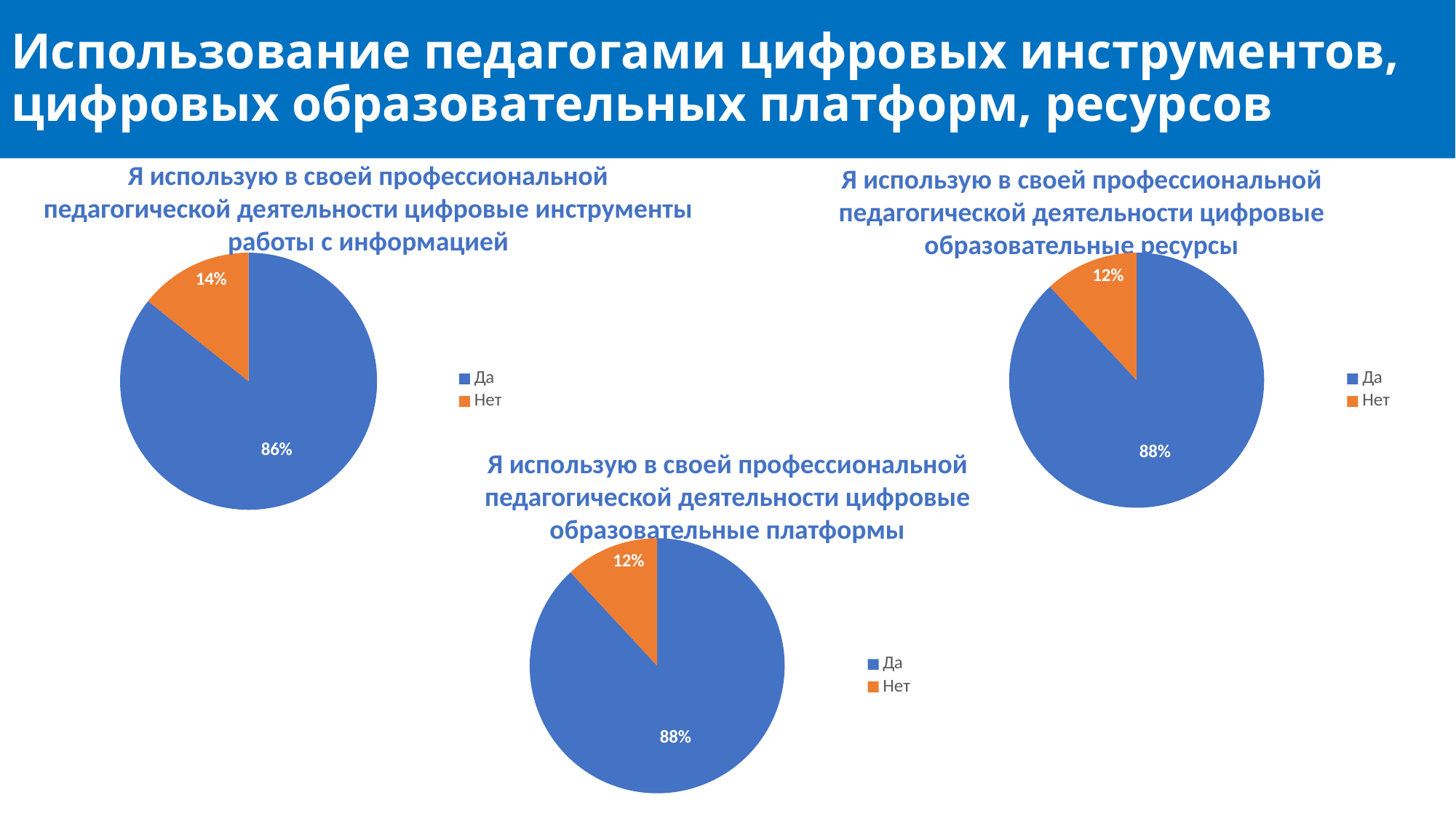
In the top-left pie chart (цифровые инструменты работы с информацией), what is the difference between the "Да" and "Нет" shares? 72% In the top-left pie chart (цифровые инструменты работы с информацией), what percentage answered "Да"? 86% In the top-right pie chart (цифровые образовательные ресурсы), what percentage answered "Нет"? 12% In the bottom pie chart (цифровые образовательные платформы), what percentage answered "Да"? 88% How many entries does the legend of the top-right pie chart (цифровые образовательные ресурсы) list? 2 In the bottom pie chart (цифровые образовательные платформы), what percentage answered "Нет"? 12% How many pie charts are shown on the slide? 3 What type of chart is used for the bottom chart (цифровые образовательные платформы)? Pie chart In the top-left pie chart (цифровые инструменты работы с информацией), what percentage answered "Нет"? 14% In the top-right pie chart (цифровые образовательные ресурсы), which answer has the smallest share? Нет In the top-left pie chart (цифровые инструменты работы с информацией), which answer has the largest share? Да In the top-right pie chart (цифровые образовательные ресурсы), what percentage answered "Да"? 88%